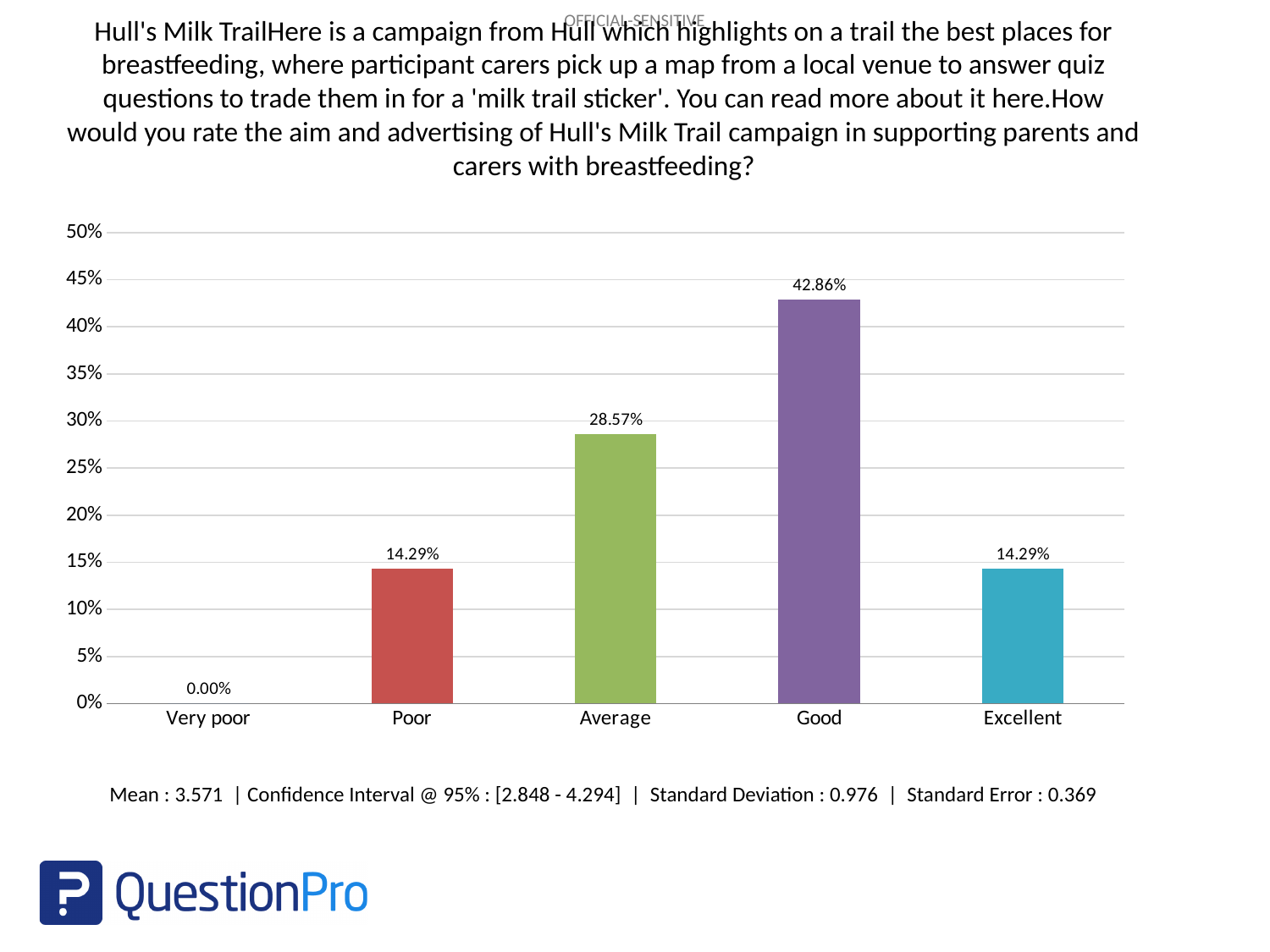
What is the value for Good? 42.86% How many categories are shown on the x axis? 5 What is the value for Very poor? 0.00% What kind of chart is shown on the slide? bar chart What mean value is reported below the chart? 3.571 What is the value for Average? 28.57% What is the value for Excellent? 14.29% Which is larger, the value for Poor or the value for Average? Average Is the value for Good greater or less than 40%? greater Which category has the highest value? Good What is the difference between the values for Good and Average? 14.29% Which category has the lowest value? Very poor